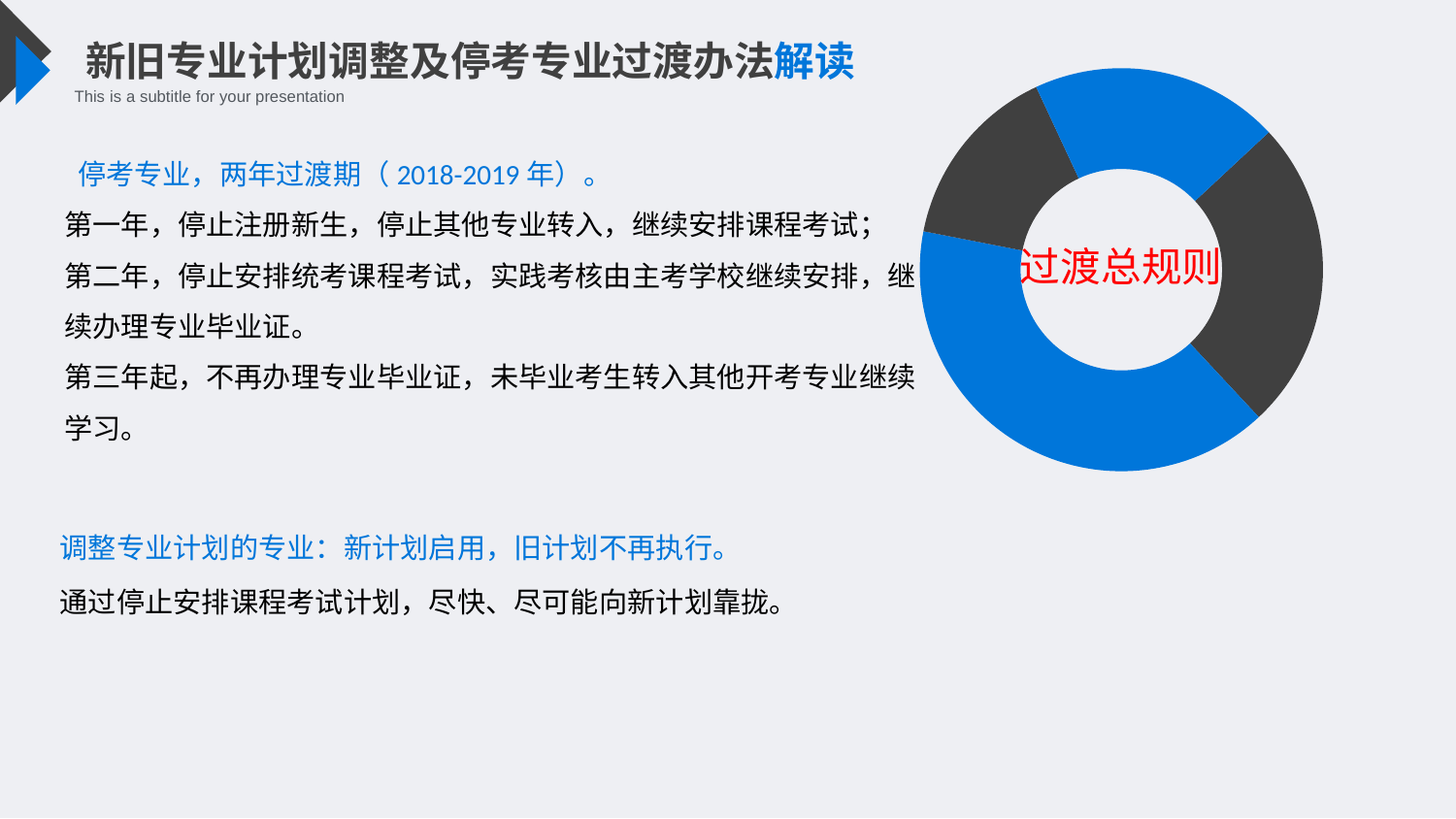
Does the doughnut chart display any data labels or a legend? No Which slice of the doughnut chart is the largest: the blue slice at the bottom-left or the dark grey slice at the top-left? The blue slice at the bottom-left How many slices does the doughnut chart on the right contain? 4 What kind of chart is shown on the right side of the slide? Doughnut chart What text is written in the centre of the doughnut chart? 过渡总规则 Which two colours are used for the slices of the doughnut chart? Blue and dark grey